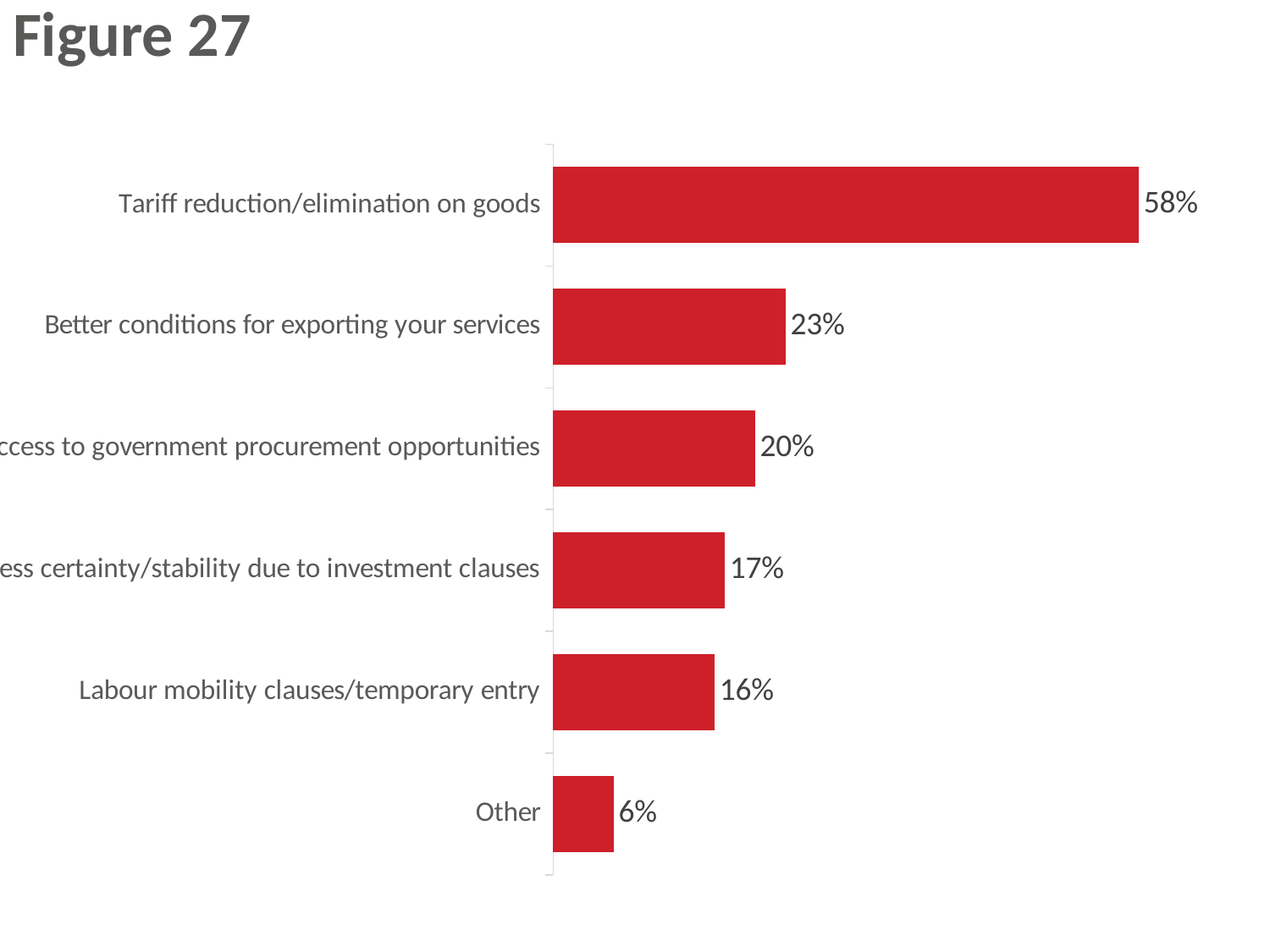
What is the value for Labour mobility clauses/temporary entry? 16% What is the value for Tariff reduction/elimination on goods? 58% Which category has the highest value? Tariff reduction/elimination on goods What is the difference between the values for Tariff reduction/elimination on goods and Better conditions for exporting your services? 35% What is the difference between the values for Labour mobility clauses/temporary entry and Other? 10% How many categories are shown in the chart? 6 What is the title shown at the top of the slide? Figure 27 What kind of chart is shown on the slide? bar chart What is the value for Better conditions for exporting your services? 23% Which is larger: the value for Better conditions for exporting your services or the value for Labour mobility clauses/temporary entry? Better conditions for exporting your services Which category has the lowest value? Other What is the value for Other? 6%